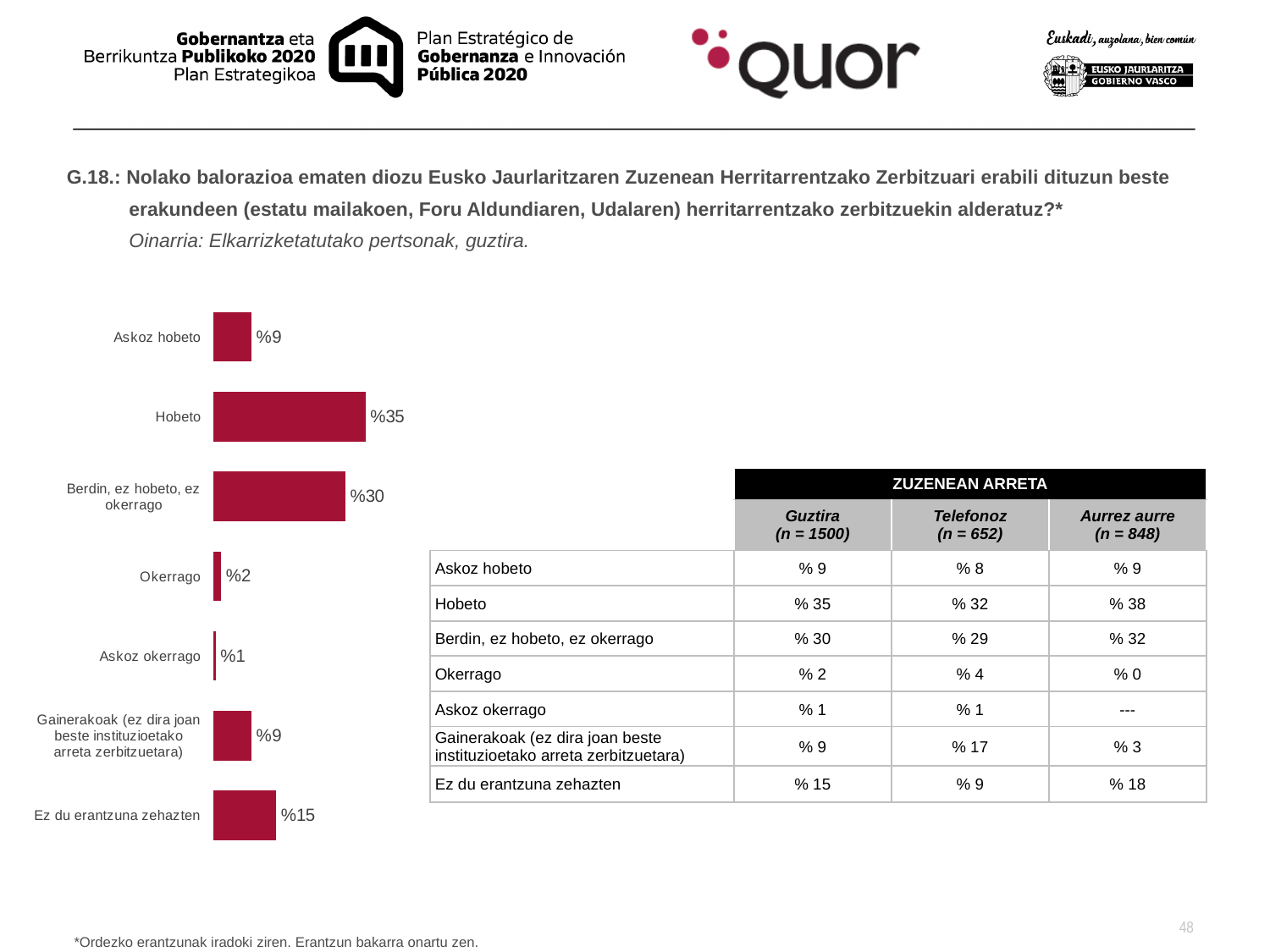
What type of chart is shown on the slide? Bar chart What is the value for "Askoz okerrago" in the bar chart? %1 Which category has the highest value in the bar chart? Hobeto What is the value for "Hobeto" in the bar chart? %35 Do "Askoz hobeto" and "Gainerakoak (ez dira joan beste instituzioetako arreta zerbitzuetara)" have the same value in the bar chart? Yes, both %9 What is the difference between the values for "Ez du erantzuna zehazten" and "Askoz hobeto" in the bar chart? %6 What is the difference between the values for "Hobeto" and "Berdin, ez hobeto, ez okerrago" in the bar chart? %5 Which category has the lowest value in the bar chart? Askoz okerrago What is the value for "Berdin, ez hobeto, ez okerrago" in the bar chart? %30 How many categories are shown in the bar chart? 7 Which is larger in the bar chart: the value for "Okerrago" or the value for "Askoz hobeto"? Askoz hobeto What is the value for "Ez du erantzuna zehazten" in the bar chart? %15